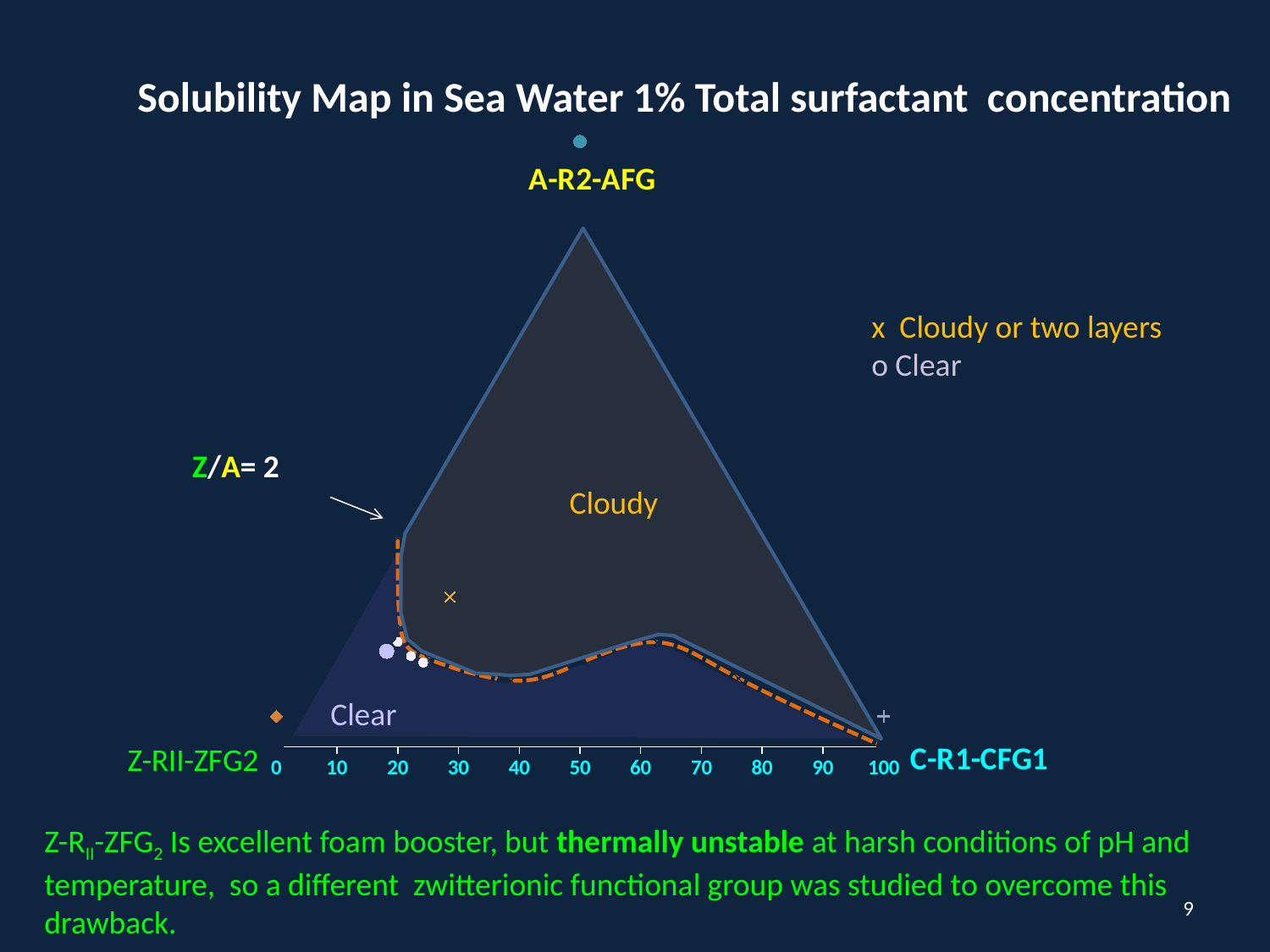
What is the highest tick value shown on the bottom axis? 100 How many tick labels are shown along the bottom axis? 11 What label is at the bottom-left corner of the triangle? Z-RII-ZFG2 How many entries does the legend list? 2 What is the title of the chart? Solubility Map in Sea Water 1% Total surfactant concentration What value is given for the Z/A ratio annotated on the chart? 2 According to the legend, what does the symbol x represent? Cloudy or two layers What label is at the bottom-right corner of the triangle? C-R1-CFG1 What is the interval between consecutive tick labels on the bottom axis? 10 Which region label appears inside the large dark polygon in the middle of the triangle? Cloudy What kind of chart is shown on the slide? Ternary (triangular) diagram What label is at the top corner of the triangle? A-R2-AFG